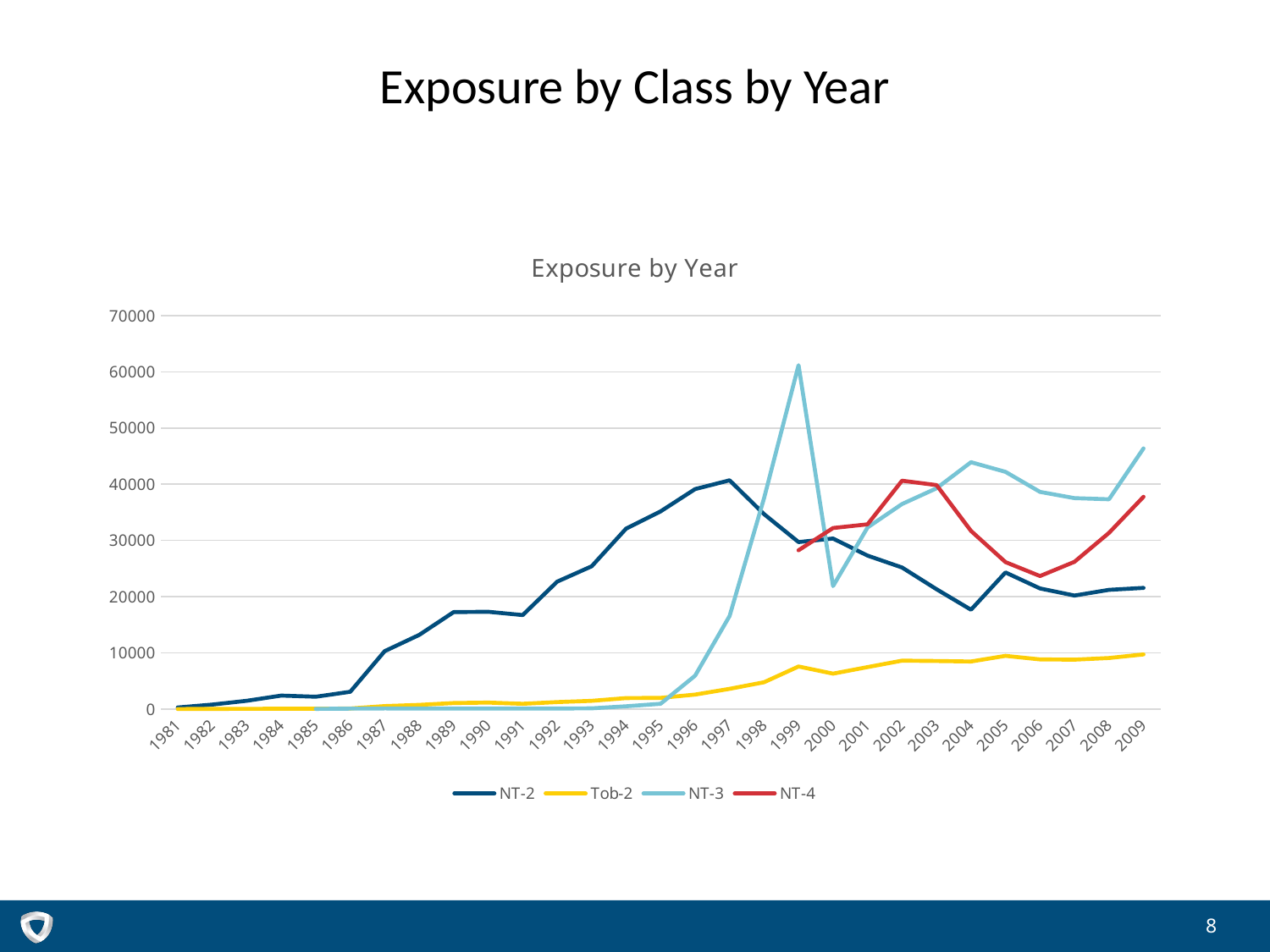
How many series does the legend of the chart list? 4 In 2009, which series has the larger value, NT-3 or NT-2? NT-3 What kind of chart is shown on the slide? line chart Is the value for NT-4 in 2002 greater or less than 30000? greater Is the value for Tob-2 in 2009 greater or less than 20000? less Which series has the lowest value in 2009? Tob-2 What is the title printed above the chart area? Exposure by Year Which series reaches the highest value anywhere on the chart? NT-3 Is the value for NT-2 in 1997 greater or less than 30000? greater How many years are shown on the x axis of the chart? 29 In 2004, which series has the larger value, NT-4 or NT-2? NT-4